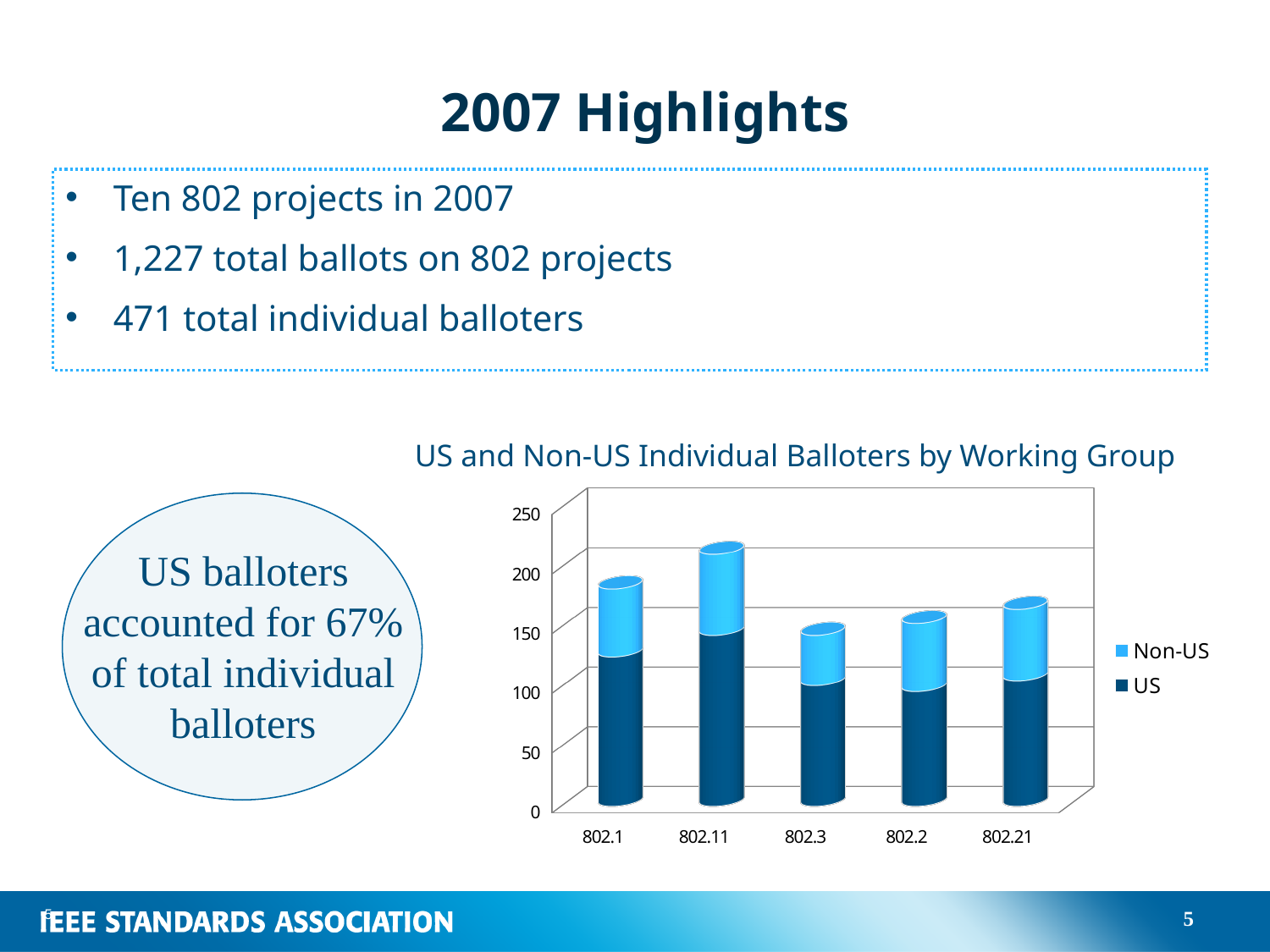
Is the US portion of the bar for 802.1 greater or less than 100? greater What kind of chart is shown on the slide? Bar chart Which two series are listed in the chart legend? Non-US and US How many working groups are shown on the x axis of the chart? 5 What is the title of the chart? US and Non-US Individual Balloters by Working Group Is the US portion of the bar for 802.11 greater or less than 100? greater How many series does the chart legend list? 2 Is the total stacked bar for 802.11 greater or less than 200? greater Which working group has the tallest stacked bar in the chart? 802.11 Which has the taller stacked bar, 802.11 or 802.1? 802.11